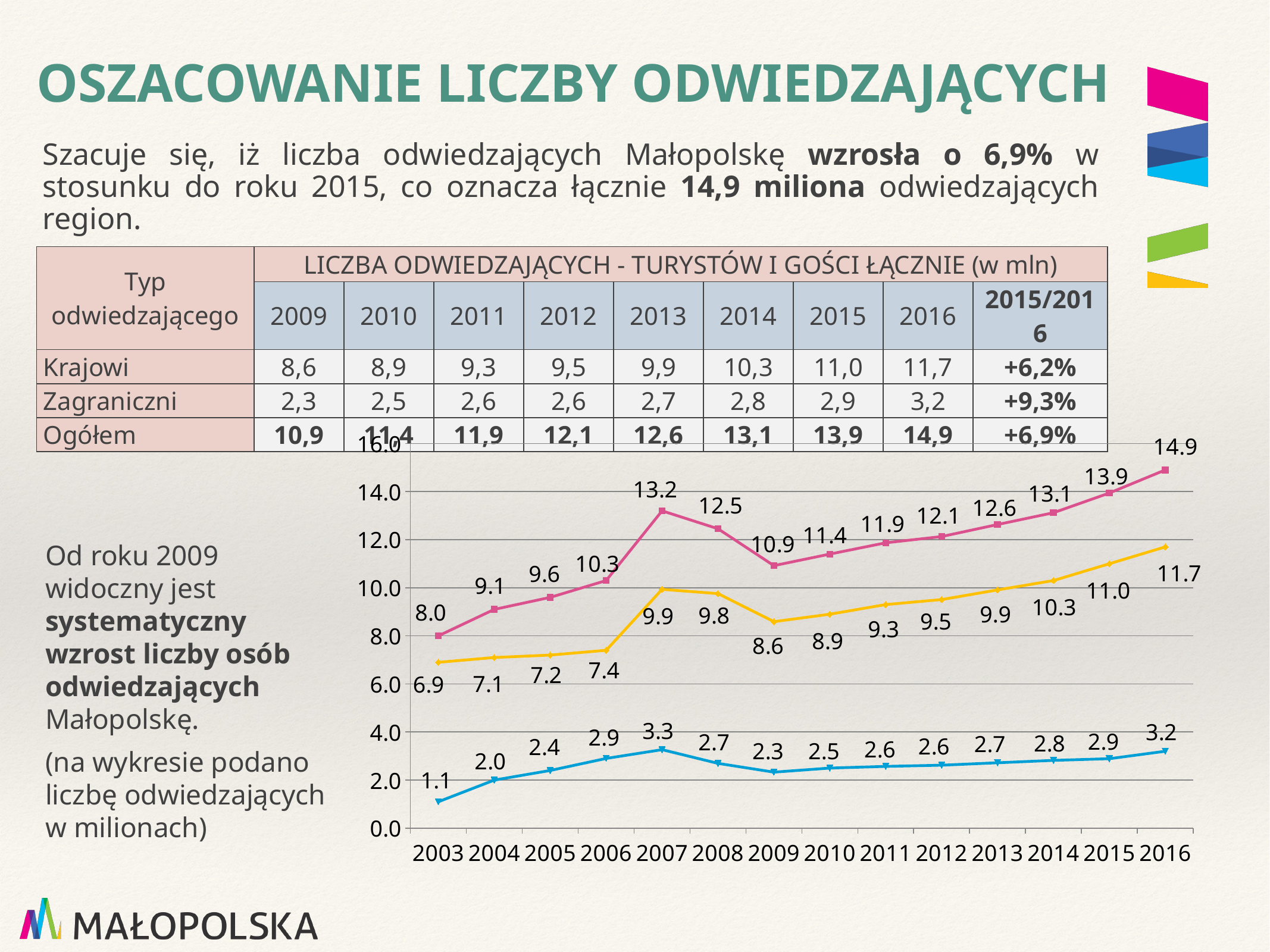
By how much does the pink line's value in 2016 exceed its value in 2015? 1.0 What is the value of the yellow line in 2007? 9.9 What is the value of the pink line in 2016? 14.9 What is the value of the blue line in 2003? 1.1 In which year is the yellow line at its lowest value? 2003 In which year does the blue line reach its highest value? 2007 What kind of chart is shown on the slide? line chart How many years are shown on the x axis of the chart? 14 Is the value of the pink line in 2009 greater or less than 12.0? less In which year does the pink line reach its highest value? 2016 Does the pink line rise or fall from 2009 to 2016? rise Which year has the larger value on the pink line, 2007 or 2008? 2007